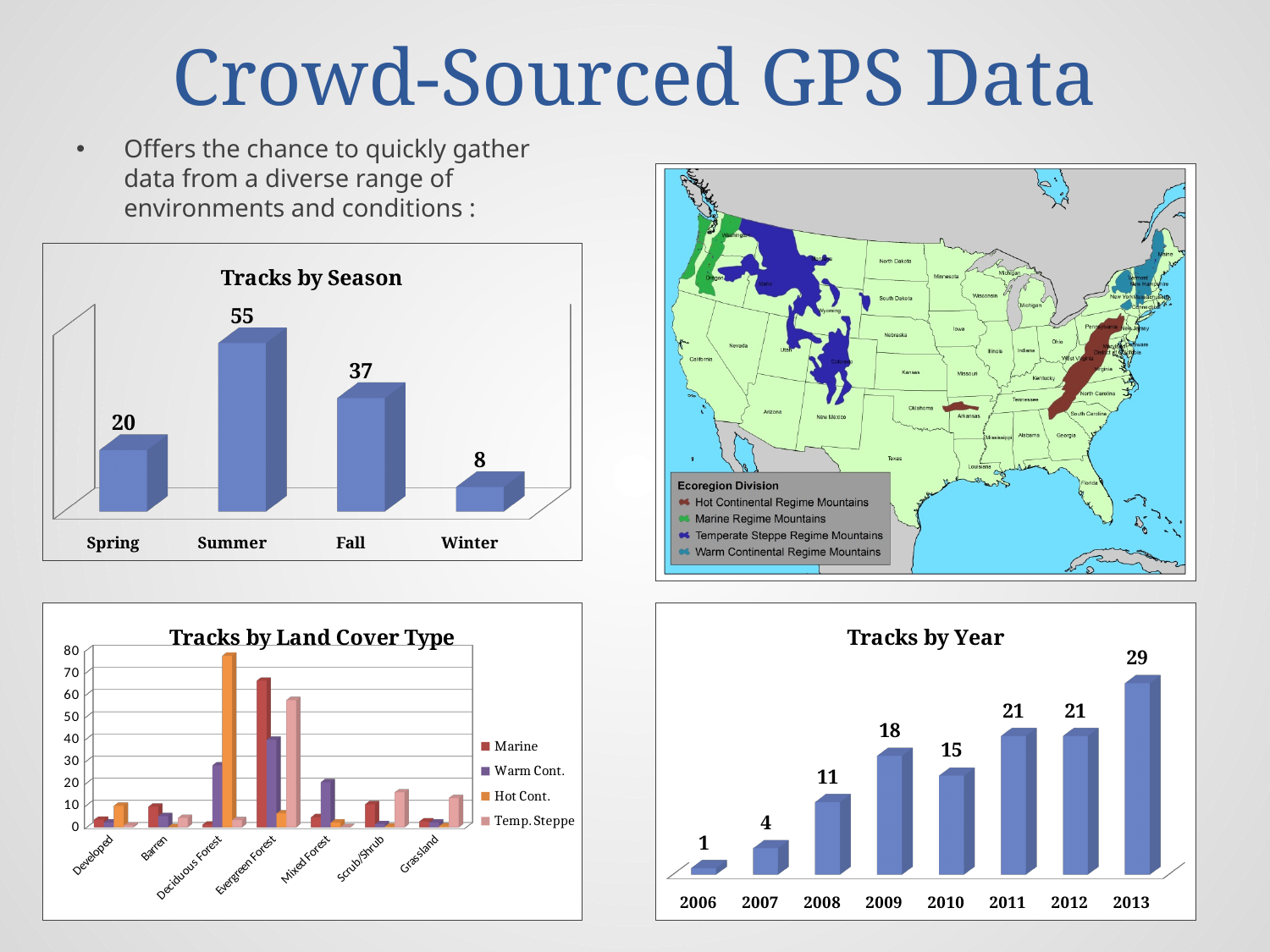
In the 'Tracks by Land Cover Type' chart, is the Hot Cont. value for Deciduous Forest greater or less than 70? greater In the 'Tracks by Year' chart, how many tracks were recorded in 2009? 18 In the 'Tracks by Year' chart, how many years are shown on the x axis? 8 In the 'Tracks by Season' chart, what is the difference between the Summer and Fall values? 18 In the 'Tracks by Season' chart, how many seasons are shown? 4 In the 'Tracks by Year' chart, which is larger, the value for 2009 or the value for 2010? 2009 What kind of chart is 'Tracks by Land Cover Type'? bar chart In the 'Tracks by Season' chart, which season has the fewest tracks? Winter In the 'Tracks by Land Cover Type' chart, how many series does the legend list? 4 In the 'Tracks by Year' chart, what is the difference between the 2013 and 2006 values? 28 In the 'Tracks by Season' chart, how many tracks were recorded in Summer? 55 In the 'Tracks by Year' chart, which year has the highest number of tracks? 2013